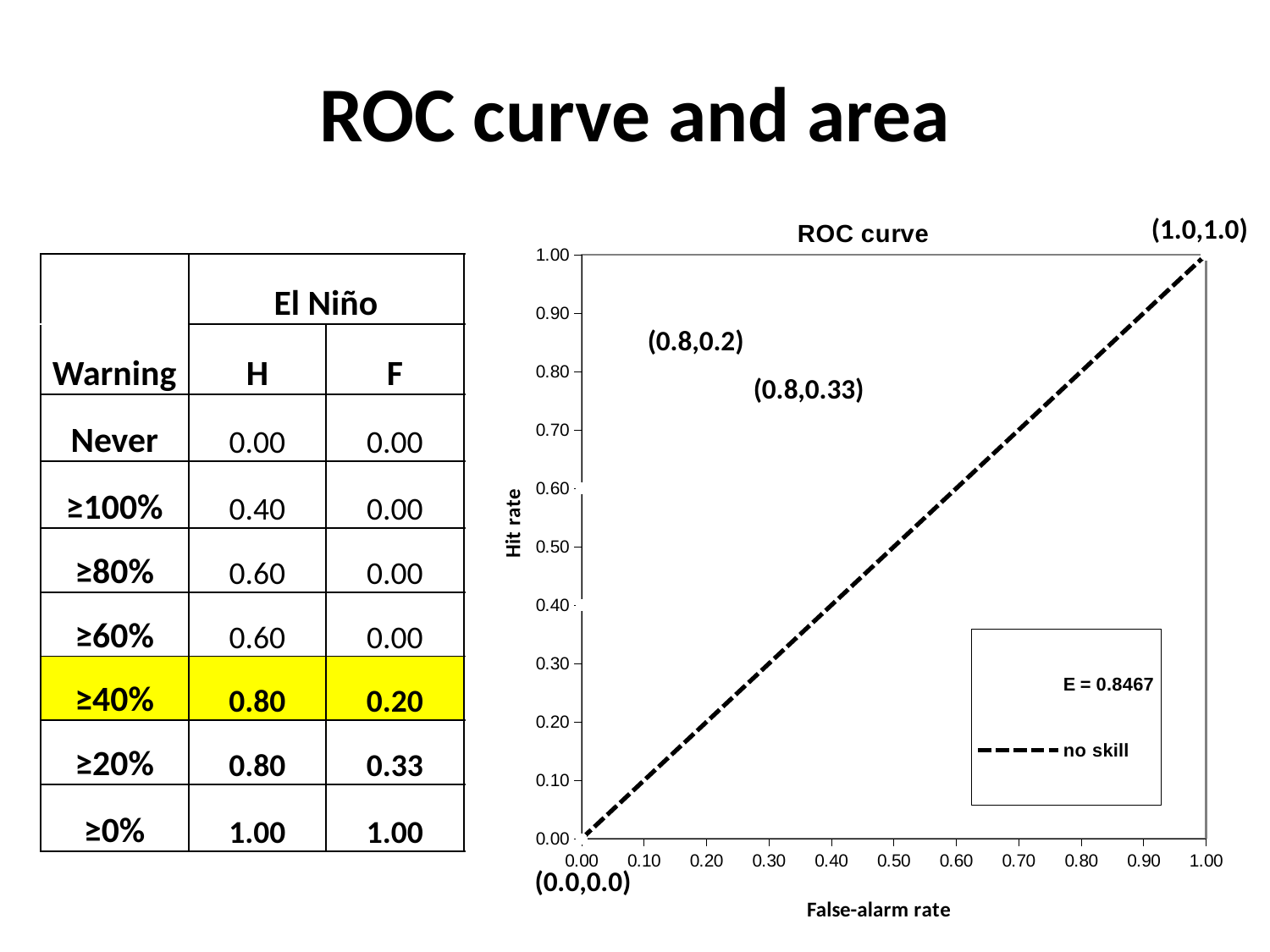
What hit rate does the no skill line reach at a false-alarm rate of 1.00? 1.00 What is the title of the chart on the slide? ROC curve What is the highest value shown on the chart's hit rate axis? 1.00 What is the name of the dashed line series in the chart's legend? no skill What value of E is shown in the chart's legend? E = 0.8467 At a false-alarm rate of 0.50, is the hit rate of the no skill line greater or less than 0.80? less How many coordinate pairs are annotated as text on the chart? 4 At a false-alarm rate of 0.50, is the hit rate of the no skill line greater or less than 0.20? greater What hit rate does the no skill line have at a false-alarm rate of 0.00? 0.00 How many entries does the chart's legend list? 2 Does the no skill line rise or fall as the false-alarm rate increases? rises What kind of chart is shown on the slide? line chart